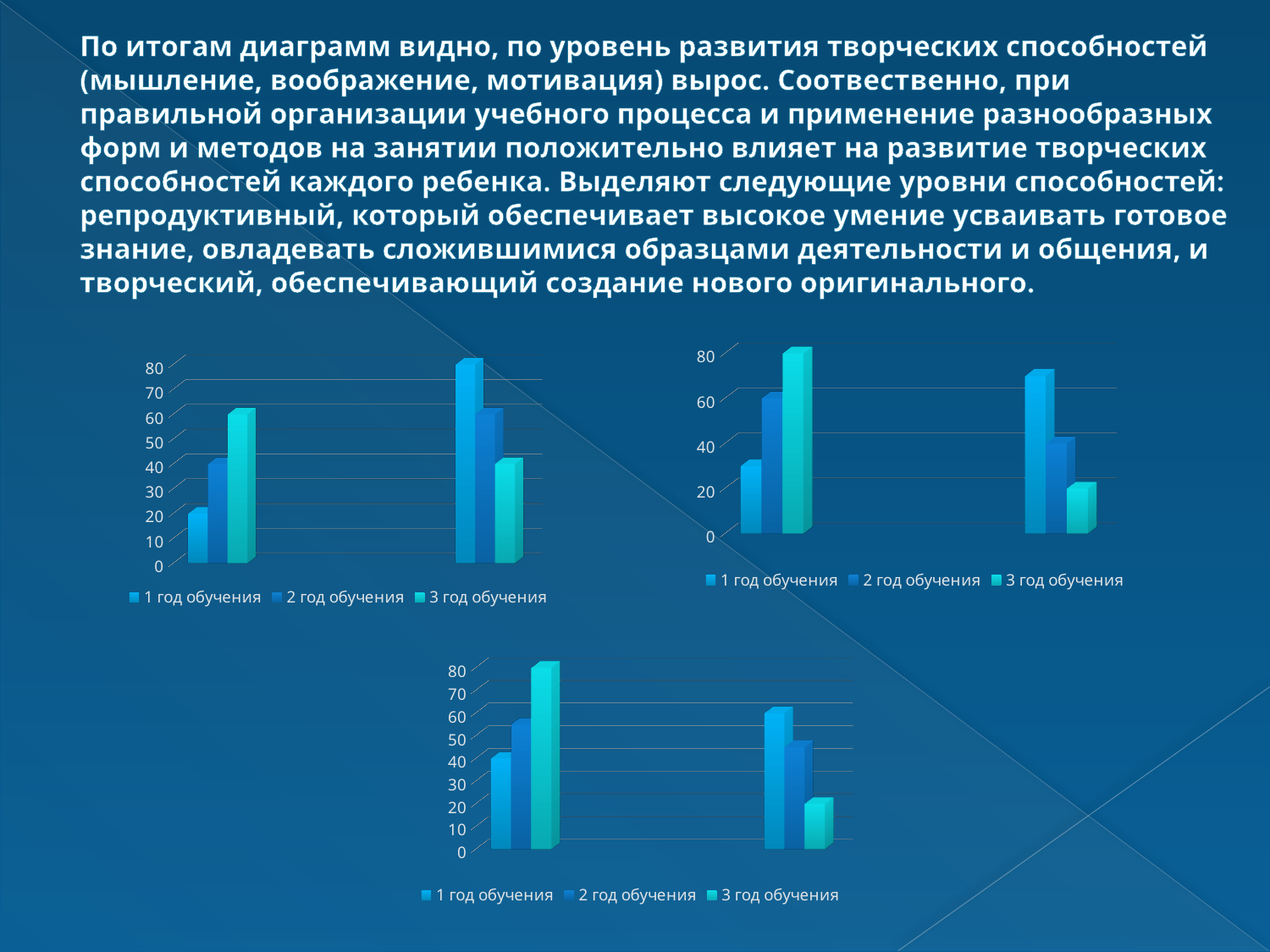
How many series does the legend of the top-left chart list? 3 What are the legend entries of the bottom chart? 1 год обучения, 2 год обучения, 3 год обучения In the bottom chart, is the value for "1 год обучения" in the right group of bars greater or less than 50? greater What kind of chart is the top-left chart on the slide? bar chart In the top-right chart, which series has the highest bar in the right group of bars? 1 год обучения In the bottom chart, which series has the lowest bar in the left group of bars? 1 год обучения In the top-right chart, in the left group of bars, which is larger: "1 год обучения" or "3 год обучения"? 3 год обучения In the top-right chart, is the value for "3 год обучения" in the right group of bars greater or less than 40? less In the top-left chart, is the value for "1 год обучения" in the right group of bars greater or less than 70? greater How many charts are shown on the slide? 3 How many groups of bars does the top-right chart show? 2